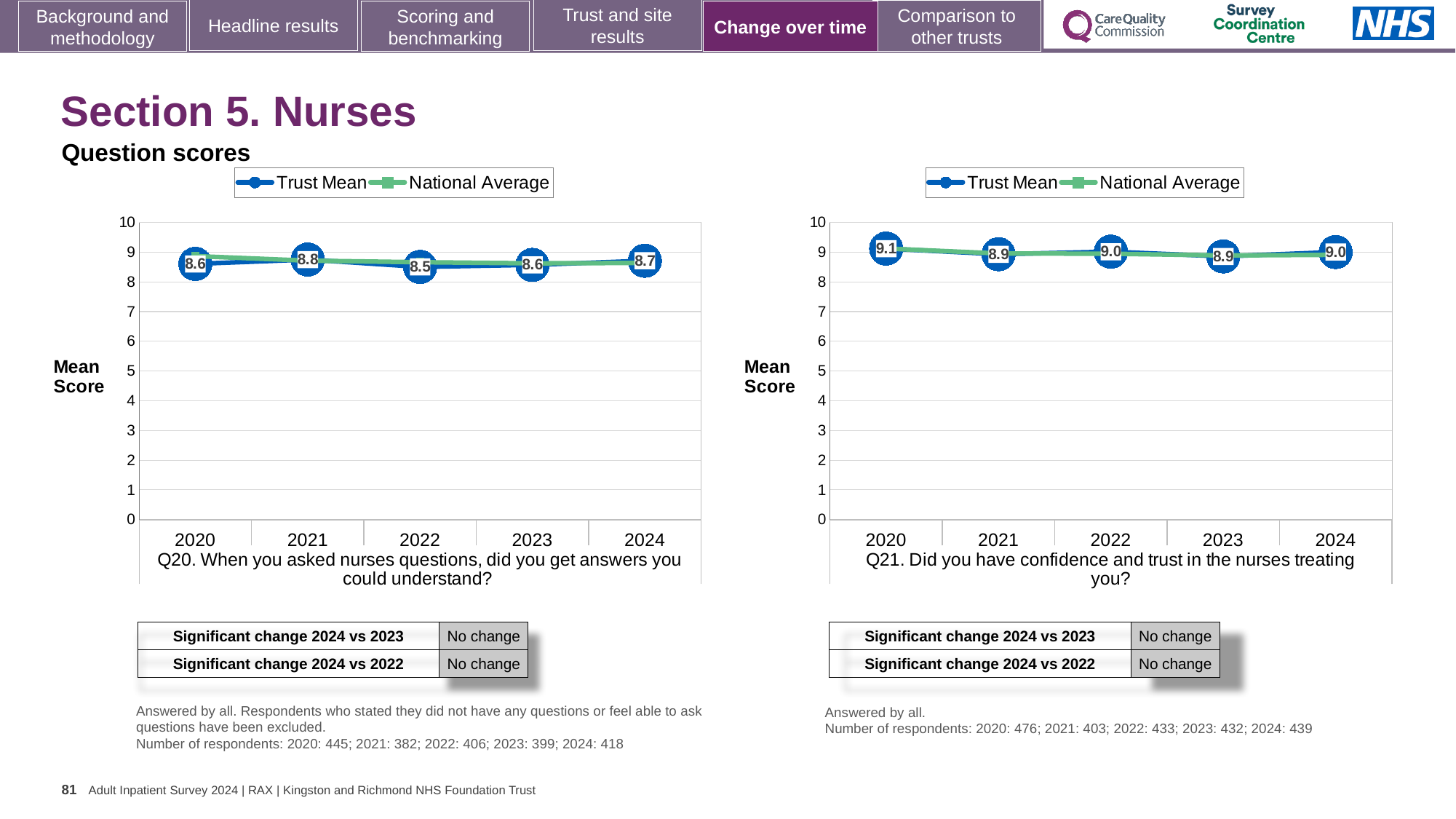
On the Q21 chart (right), is the Trust Mean score for 2020 larger or smaller than the score for 2021? larger How many years are plotted on the Q21 chart (right)? 5 How many series does the legend of the Q20 chart (left) list? 2 On the Q20 chart (left), what is the Trust Mean score for 2024? 8.7 On the Q21 chart (right), which year has the highest Trust Mean score? 2020 On the Q21 chart (right), what is the Trust Mean score for 2023? 8.9 On the Q20 chart (left), what is the difference between the Trust Mean scores for 2021 and 2022? 0.3 On the Q20 chart (left), is the National Average value for 2020 greater or less than 8? greater On the Q20 chart (left), which year has the highest Trust Mean score? 2021 On the Q20 chart (left), which year has the lowest Trust Mean score? 2022 On the Q20 chart (left), what is the Trust Mean score for 2021? 8.8 On the Q21 chart (right), what is the Trust Mean score for 2020? 9.1